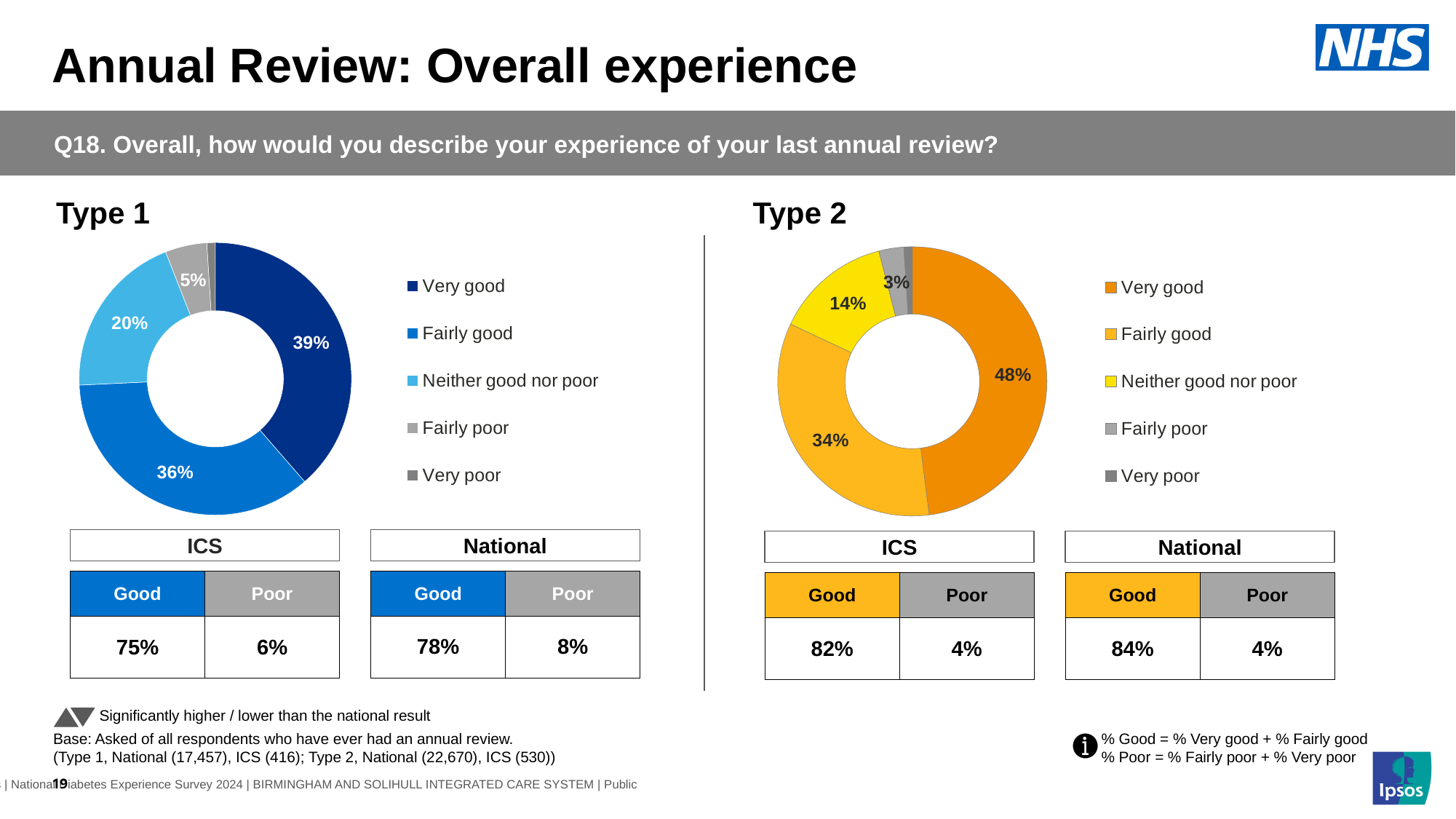
In the Type 2 chart, what is the difference between the 'Very good' and 'Fairly good' shares? 14% How many response categories does the legend of the Type 2 chart list? 5 In the Type 1 chart, what percentage of respondents said their experience was 'Very good'? 39% In the Type 2 chart, what percentage of respondents said 'Fairly good'? 34% Which chart has the larger 'Neither good nor poor' share, Type 1 or Type 2? Type 1 In the Type 1 chart, what percentage of respondents said 'Neither good nor poor'? 20% In the Type 2 chart, what percentage of respondents said their experience was 'Very good'? 48% In the Type 2 chart, which response category has the largest share? Very good What kind of chart is used to show the Type 1 results? Donut (pie) chart In the Type 1 chart, what is the difference between the 'Very good' and 'Fairly good' shares? 3% In the Type 2 chart, what percentage of respondents said 'Fairly poor'? 3% In the Type 1 chart, which response category has the largest share? Very good